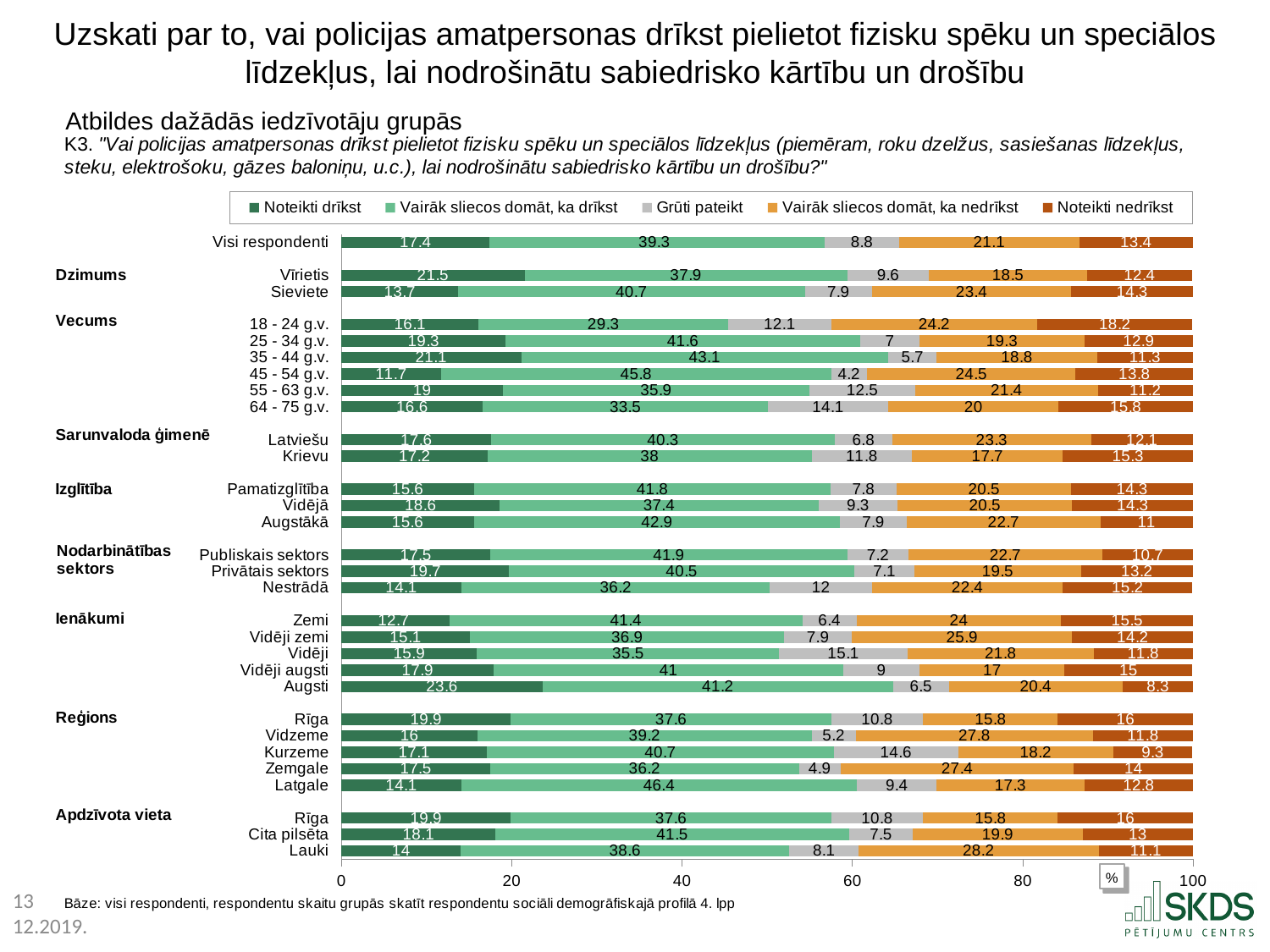
What is the value of "Grūti pateikt" for Kurzeme? 14.6 What kind of chart is shown on the slide? Stacked bar chart What is the value of "Vairāk sliecos domāt, ka nedrīkst" for Sieviete? 23.4 Among the Reģions groups, which has the lowest "Grūti pateikt" value? Zemgale What is the value of "Noteikti drīkst" for Visi respondenti? 17.4 Among the Vecums groups, which has the highest "Noteikti drīkst" value? 35 - 44 g.v. What is the value of "Noteikti nedrīkst" for the 18 - 24 g.v. group? 18.2 Among the Ienākumi groups, which has the highest "Noteikti drīkst" value? Augsti What is the value of "Vairāk sliecos domāt, ka drīkst" for Latgale? 46.4 How many series does the legend list? 5 Which has a larger "Vairāk sliecos domāt, ka nedrīkst" value, Latviešu or Krievu? Latviešu What is the difference between the "Noteikti drīkst" values for Vīrietis and Sieviete? 7.8